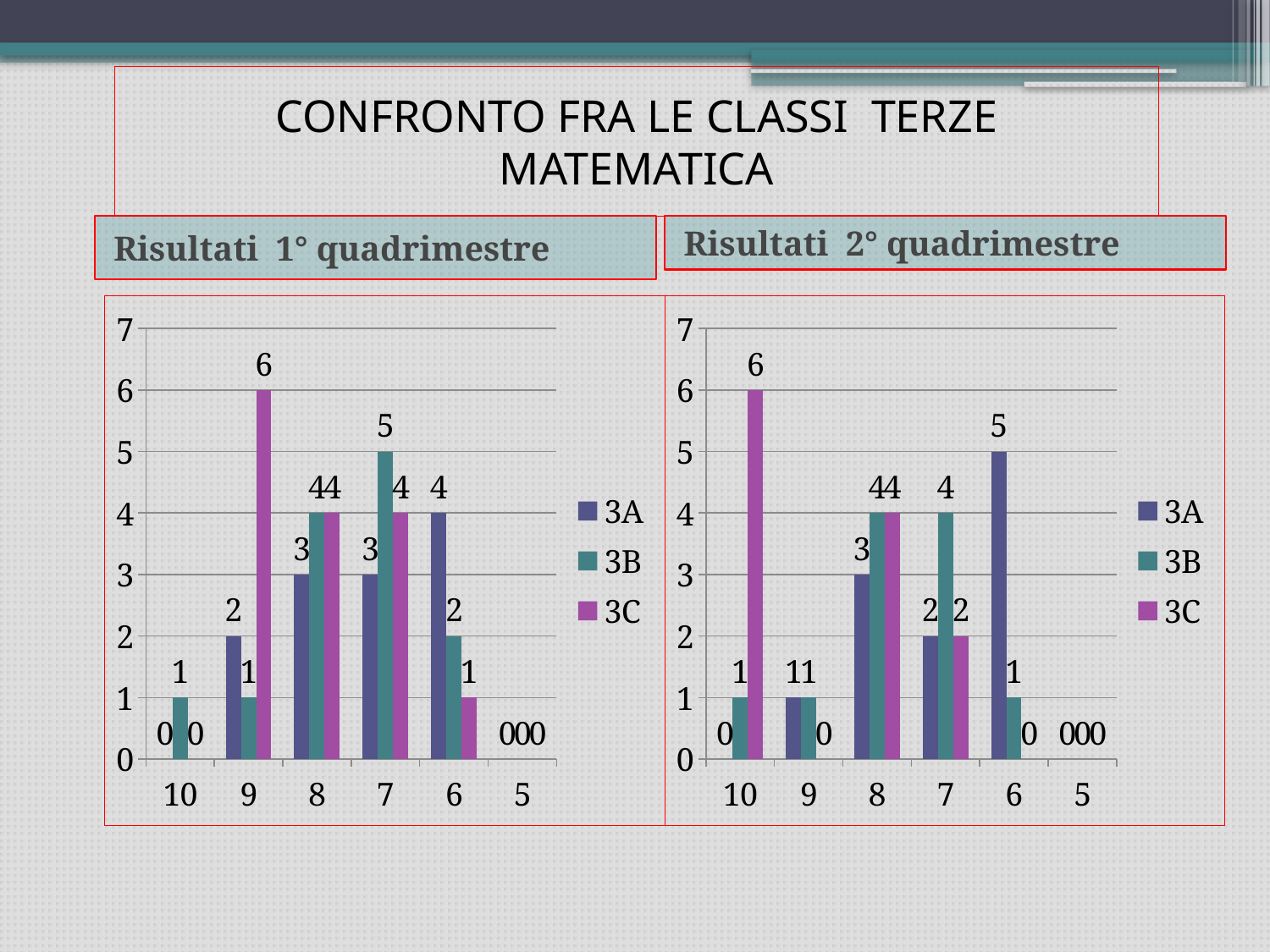
In the 'Risultati 1° quadrimestre' chart, which category has the highest value for 3A? 6 In the 'Risultati 1° quadrimestre' chart, what is the value for 3B at category 7? 5 In the 'Risultati 2° quadrimestre' chart, what is the value for 3C at category 10? 6 In the 'Risultati 2° quadrimestre' chart, which is larger at category 7: the value for 3B or the value for 3A? 3B How many series does the legend of the 'Risultati 1° quadrimestre' chart list? 3 In the 'Risultati 1° quadrimestre' chart, what is the difference between the 3C value at category 9 and the 3A value at category 9? 4 In the 'Risultati 1° quadrimestre' chart, what is the value for 3C at category 9? 6 In the 'Risultati 2° quadrimestre' chart, what is the total of the three series at category 8? 11 In the 'Risultati 2° quadrimestre' chart, which category has the highest value for 3B? 8 In the 'Risultati 2° quadrimestre' chart, what is the value for 3A at category 6? 5 How many categories are shown on the x axis of the 'Risultati 2° quadrimestre' chart? 6 What kind of chart is the 'Risultati 2° quadrimestre' chart? Bar chart